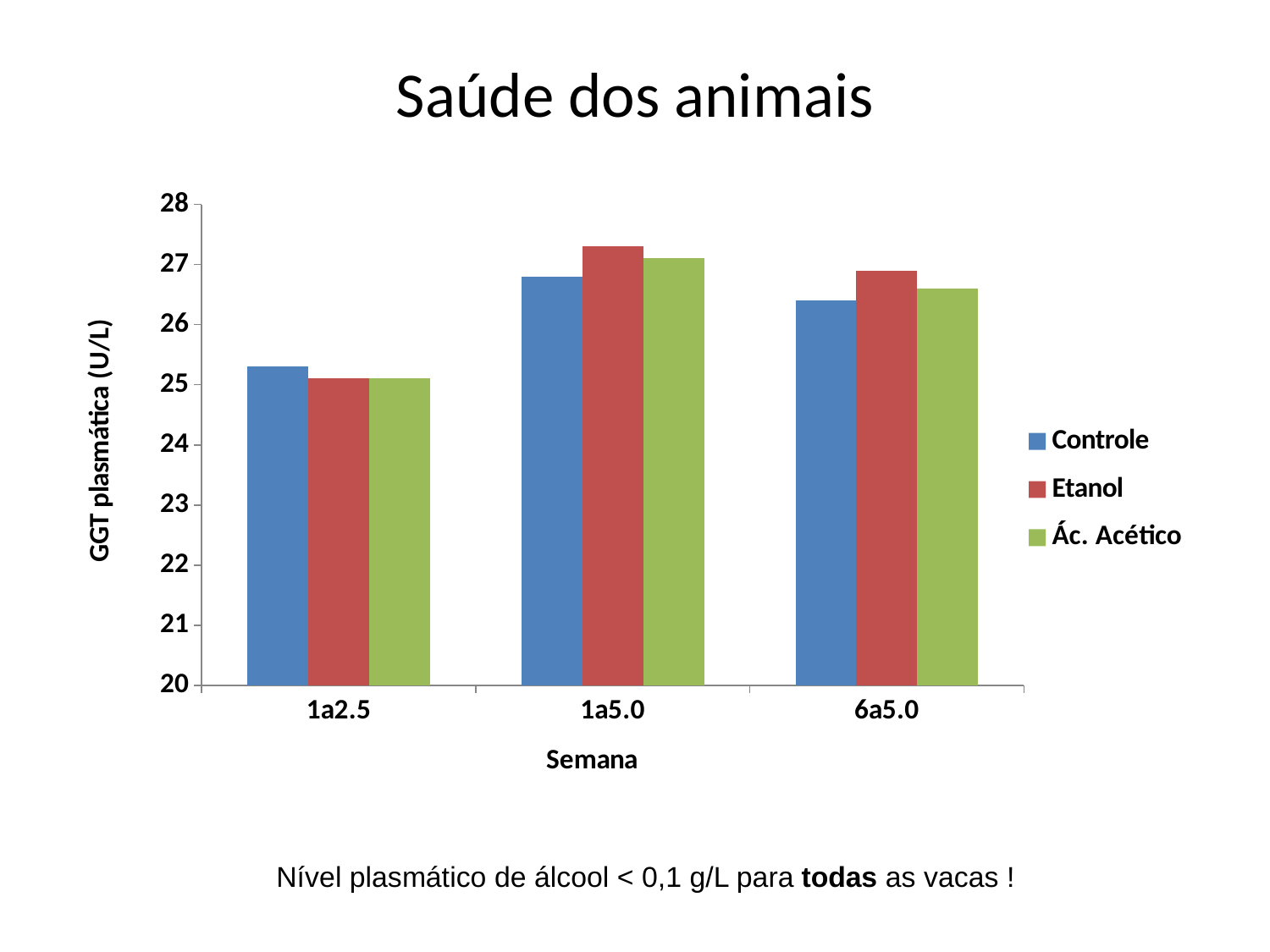
Which is larger: the Etanol value at 1a5.0 or the Etanol value at 6a5.0? 1a5.0 Which series has the lowest bar in the 6a5.0 category? Controle Is the value for Controle at 1a2.5 greater or less than 25? greater Does the Controle value rise or fall from 1a2.5 to 1a5.0? rise What kind of chart is shown on the slide? bar chart Is the value for Controle at 1a5.0 greater or less than 27? less Is the value for Etanol at 1a5.0 greater or less than 27? greater Which series has the highest bar in the 6a5.0 category? Etanol Which series has the highest bar in the 1a5.0 category? Etanol How many categories are shown on the x axis? 3 What is the title of the y axis? GGT plasmática (U/L) How many series does the legend list? 3